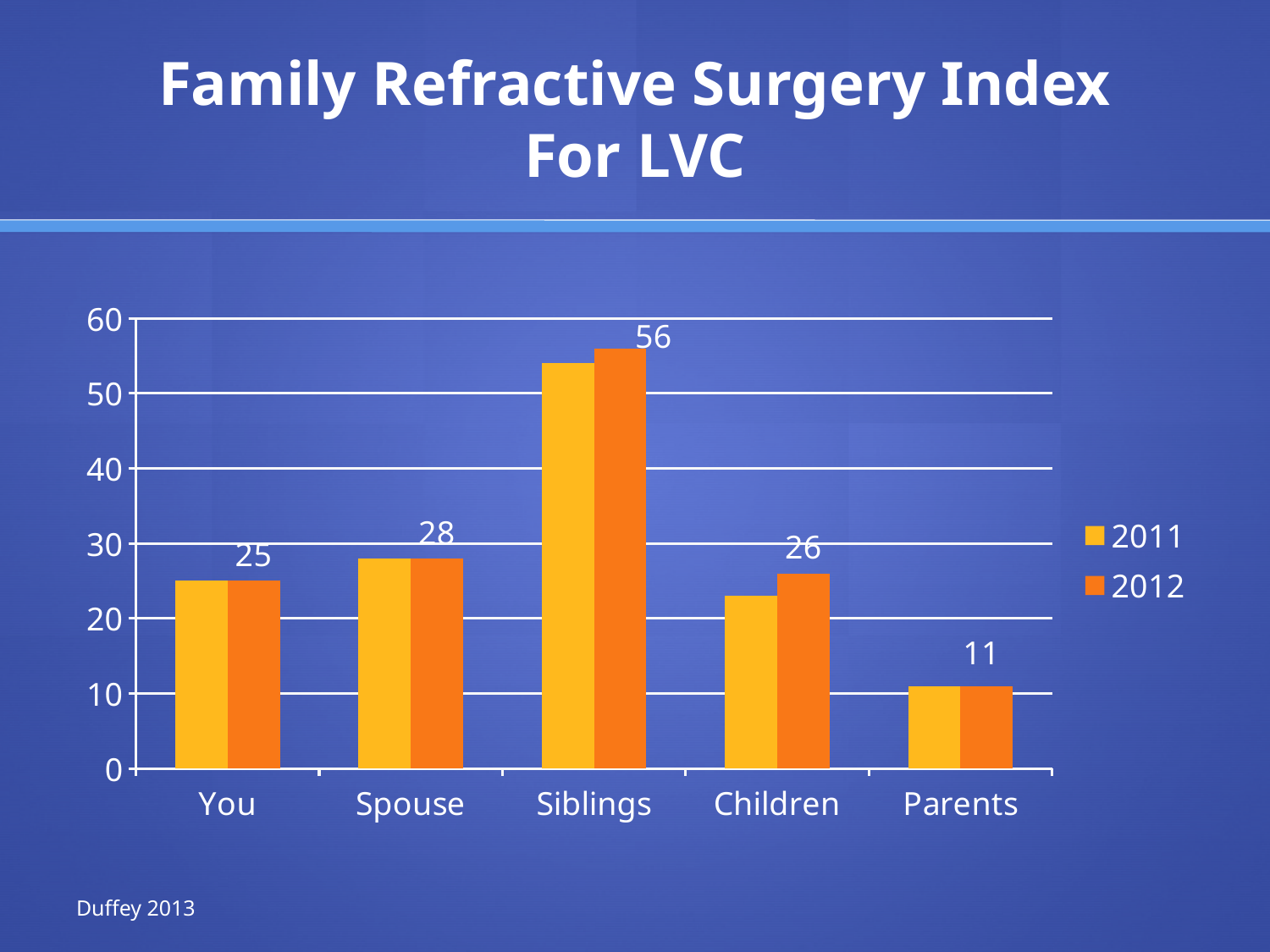
What kind of chart is shown on the slide? Bar chart What is the 2012 value for Parents? 11 How many series does the legend list? 2 Which has a larger 2012 value, Spouse or Children? Spouse What is the 2012 value for Spouse? 28 What is the difference between the 2012 values for Siblings and Parents? 45 Which category has the highest 2012 value? Siblings Is the 2011 value for Siblings greater or less than 50? greater Which category has the lowest 2012 value? Parents How many categories are shown on the x axis? 5 Is the 2011 value for Children greater or less than 30? less What is the 2012 value for Siblings? 56